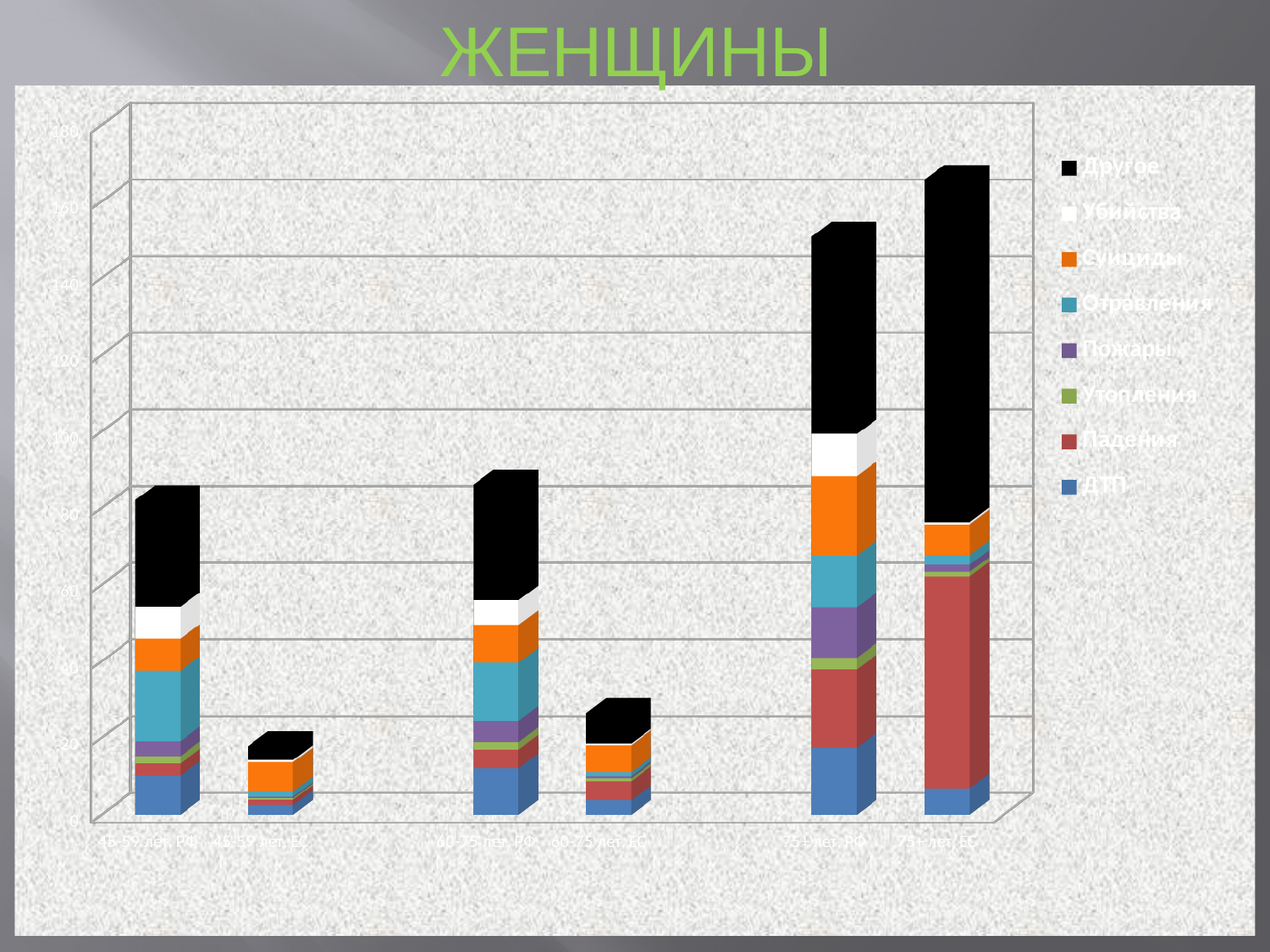
Which category has the tallest stacked bar? 75+ лет ЕС What kind of chart is shown on the slide? Stacked bar chart What is the title of the slide above the chart? ЖЕНЩИНЫ Is the total of the bar for 75+ лет РФ greater or less than 140? greater Is the total of the bar for 60-75 лет ЕС greater or less than 40? less Which colour represents the series 'Другое' in the legend? Black How many series does the legend list? 8 Which category has the shortest stacked bar? 45-59 лет, ЕС How many bars (categories) are plotted on the chart? 6 Is the total of the rightmost bar (75+ лет ЕС) greater or less than 160? greater